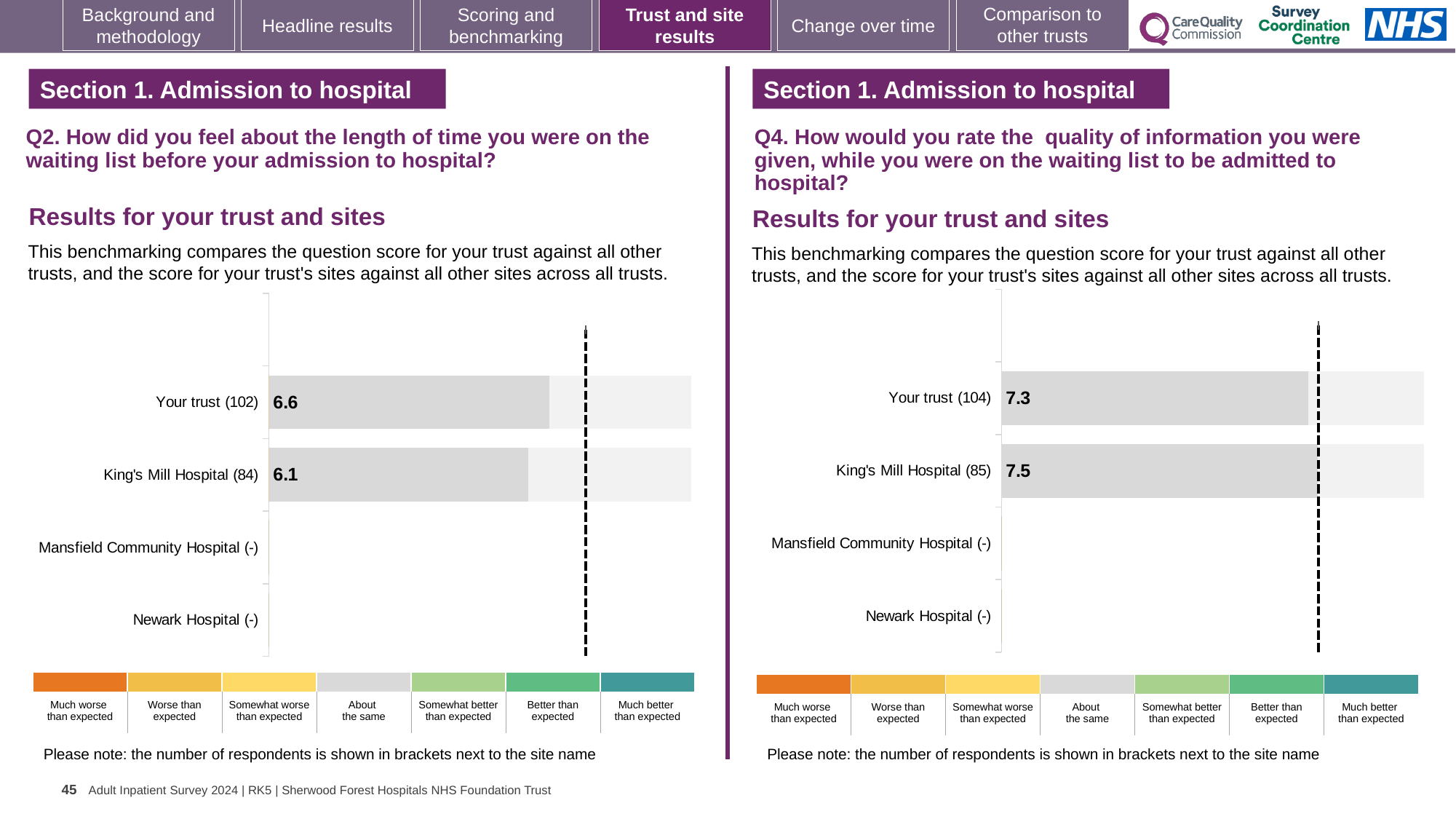
What kind of chart is used for the Q4 results on the right? Bar chart In the Q4 chart on the right, which has the higher score, Your trust or King's Mill Hospital? King's Mill Hospital In the Q2 chart on the left, which has the higher score, Your trust or King's Mill Hospital? Your trust In the Q4 chart on the right, what is the score for Your trust (104)? 7.3 In the Q2 chart on the left, what is the score for King's Mill Hospital (84)? 6.1 In the Q4 chart on the right, what is the score for King's Mill Hospital (85)? 7.5 In the Q2 chart on the left, how many respondents are shown in brackets for King's Mill Hospital? 84 In the Q2 chart on the left, what is the score for Your trust (102)? 6.6 In the Q2 chart on the left, what is the difference between the scores for Your trust and King's Mill Hospital? 0.5 How many site/trust categories are listed on the y axis of the Q2 chart on the left? 4 In the Q4 chart on the right, what is the difference between the scores for King's Mill Hospital and Your trust? 0.2 In the Q4 chart on the right, which two sites have no score shown (marked with a dash)? Mansfield Community Hospital and Newark Hospital